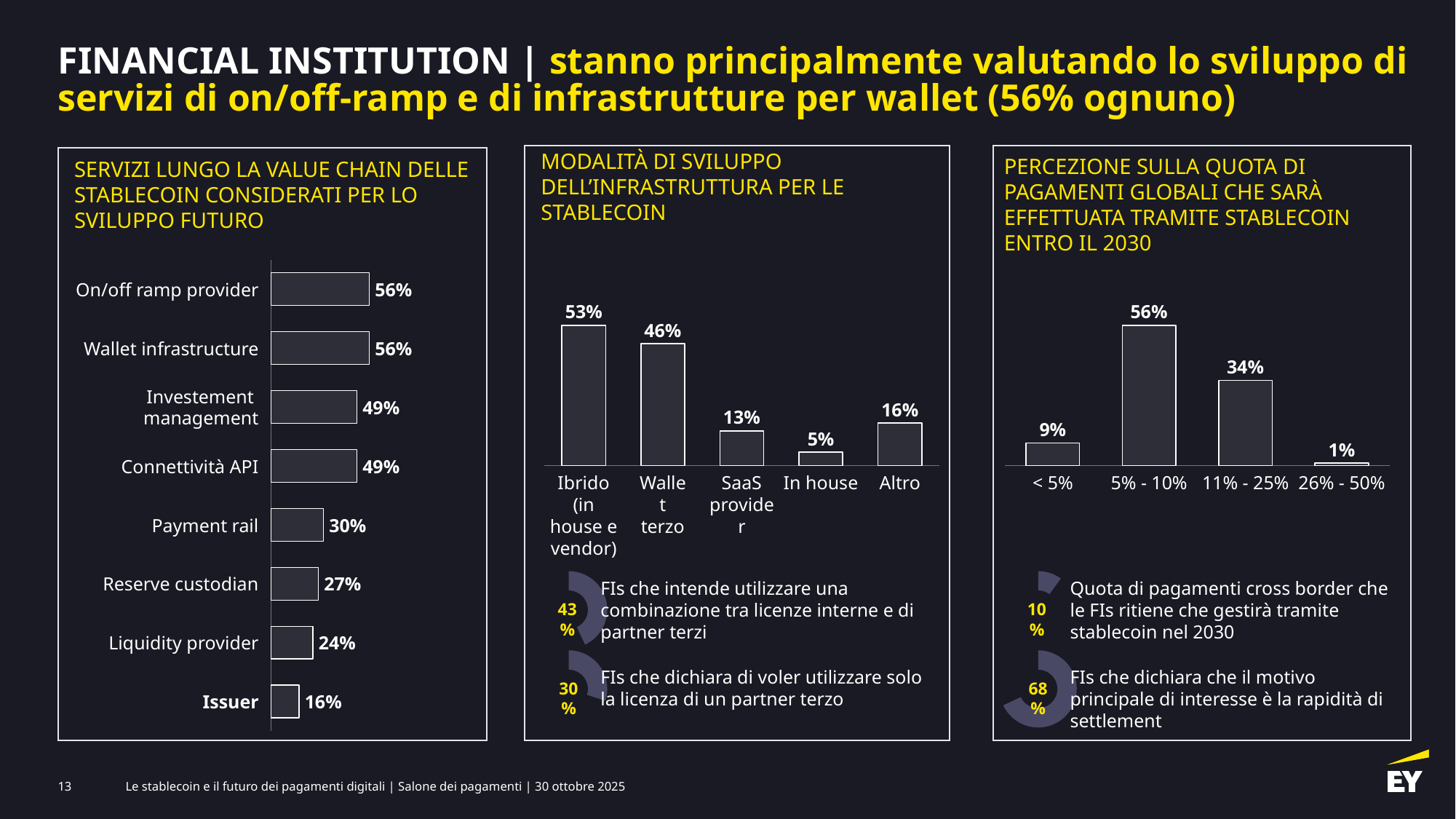
What kind of chart is the left chart 'Servizi lungo la value chain delle stablecoin considerati per lo sviluppo futuro'? Bar chart In the right chart 'Percezione sulla quota di pagamenti globali che sarà effettuata tramite stablecoin entro il 2030', which category has the lowest value? 26% - 50% In the left chart 'Servizi lungo la value chain delle stablecoin considerati per lo sviluppo futuro', how many categories are shown? 8 In the middle chart 'Modalità di sviluppo dell'infrastruttura per le stablecoin', which is larger: Altro or In house? Altro In the left chart 'Servizi lungo la value chain delle stablecoin considerati per lo sviluppo futuro', which category has the lowest value? Issuer In the left chart 'Servizi lungo la value chain delle stablecoin considerati per lo sviluppo futuro', what is the value for Payment rail? 30% In the right chart 'Percezione sulla quota di pagamenti globali che sarà effettuata tramite stablecoin entro il 2030', how many categories are shown? 4 In the right chart 'Percezione sulla quota di pagamenti globali che sarà effettuata tramite stablecoin entro il 2030', what is the value for 11% - 25%? 34% In the middle chart 'Modalità di sviluppo dell'infrastruttura per le stablecoin', which category has the highest value? Ibrido (in house e vendor) In the middle chart 'Modalità di sviluppo dell'infrastruttura per le stablecoin', what is the value for SaaS provider? 13% In the middle chart 'Modalità di sviluppo dell'infrastruttura per le stablecoin', what is the difference between Ibrido (in house e vendor) and Wallet terzo? 7% In the left chart 'Servizi lungo la value chain delle stablecoin considerati per lo sviluppo futuro', what is the difference between Reserve custodian and Liquidity provider? 3%